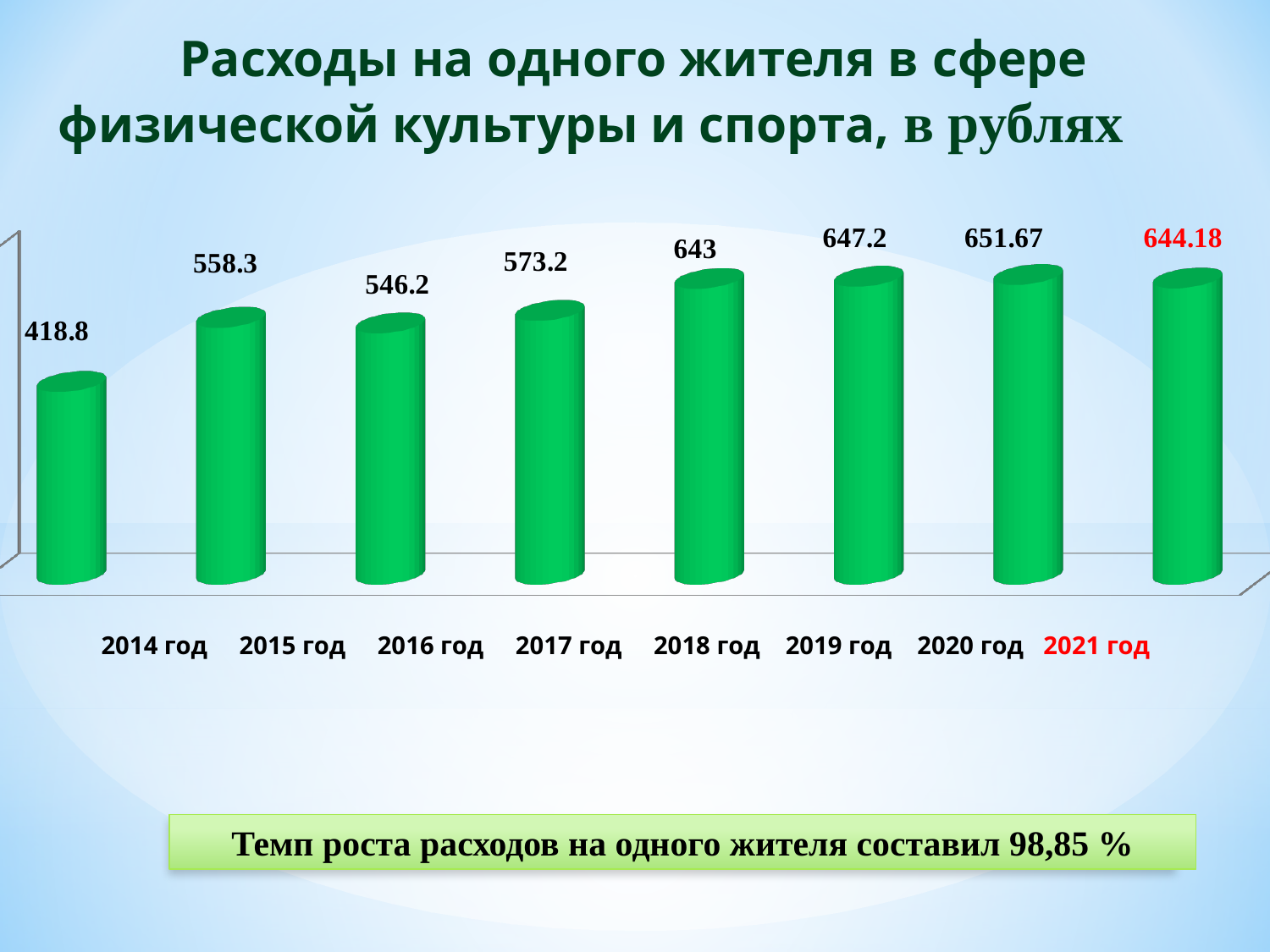
Which year label on the x axis is shown in red? 2021 год What is the value for 2014 год? 418.8 What is the difference between the values for 2020 год and 2021 год? 7.49 Which year has the lowest value? 2014 год What is the difference between the values for 2015 год and 2014 год? 139.5 Between 2017 год and 2020 год, do the values rise or fall? rise What kind of chart is shown on the slide? bar chart Which year has the highest value? 2020 год What is the value for 2018 год? 643 Which is larger, the value for 2015 год or 2016 год? 2015 год What is the value for 2021 год? 644.18 How many years are shown on the chart? 8